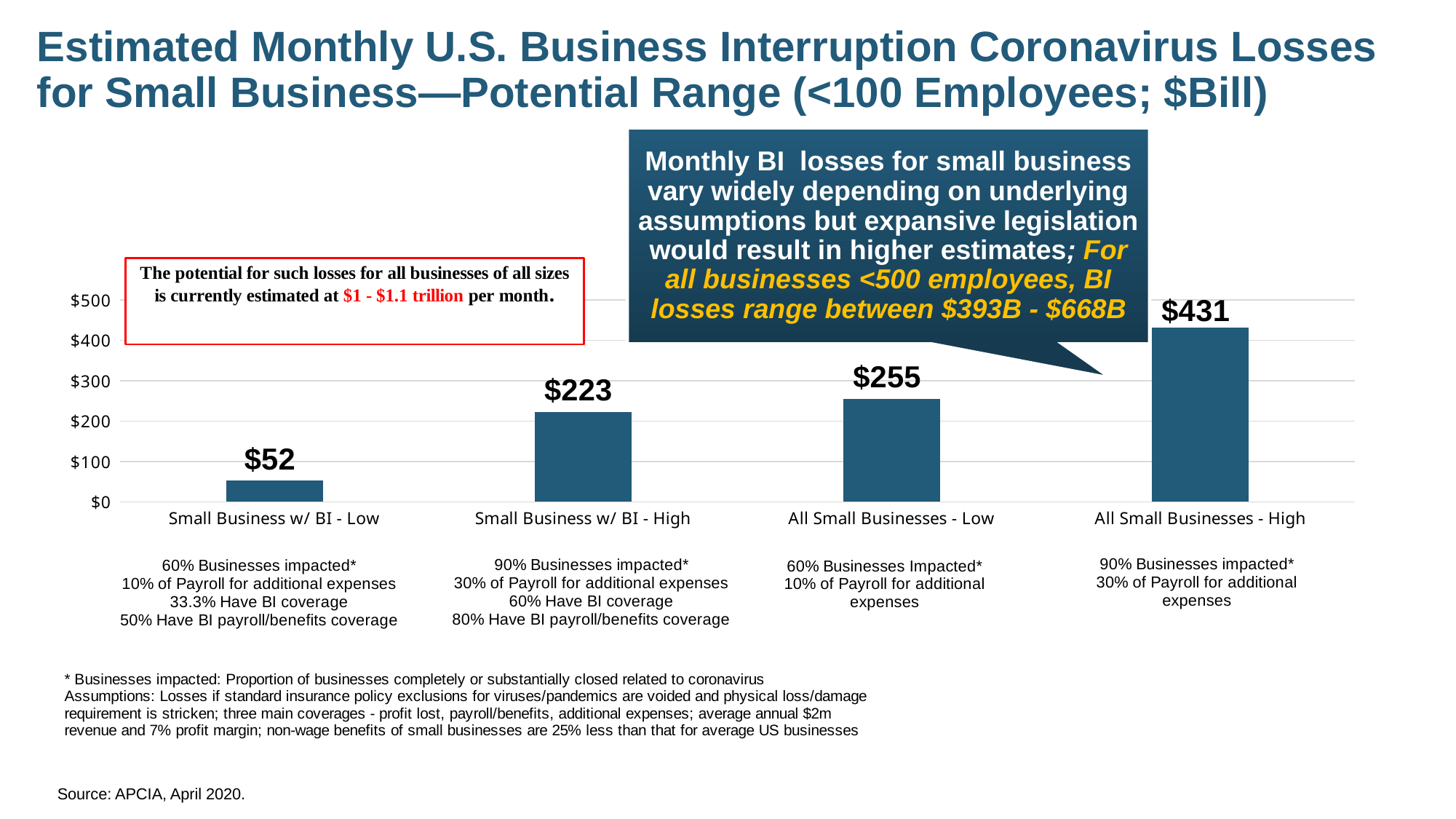
What is the value for All Small Businesses - Low? $255 How many categories are shown in the chart? 4 Which category has the highest value? All Small Businesses - High What is the difference between All Small Businesses - High and All Small Businesses - Low? $176 Which category has the lowest value? Small Business w/ BI - Low What is the value for Small Business w/ BI - High? $223 What is the value for Small Business w/ BI - Low? $52 Do the values rise or fall from left to right across the categories? Rise What kind of chart is shown on the slide? Bar chart What is the value for All Small Businesses - High? $431 What is the difference between Small Business w/ BI - High and Small Business w/ BI - Low? $171 Which is larger, Small Business w/ BI - High or All Small Businesses - Low? All Small Businesses - Low